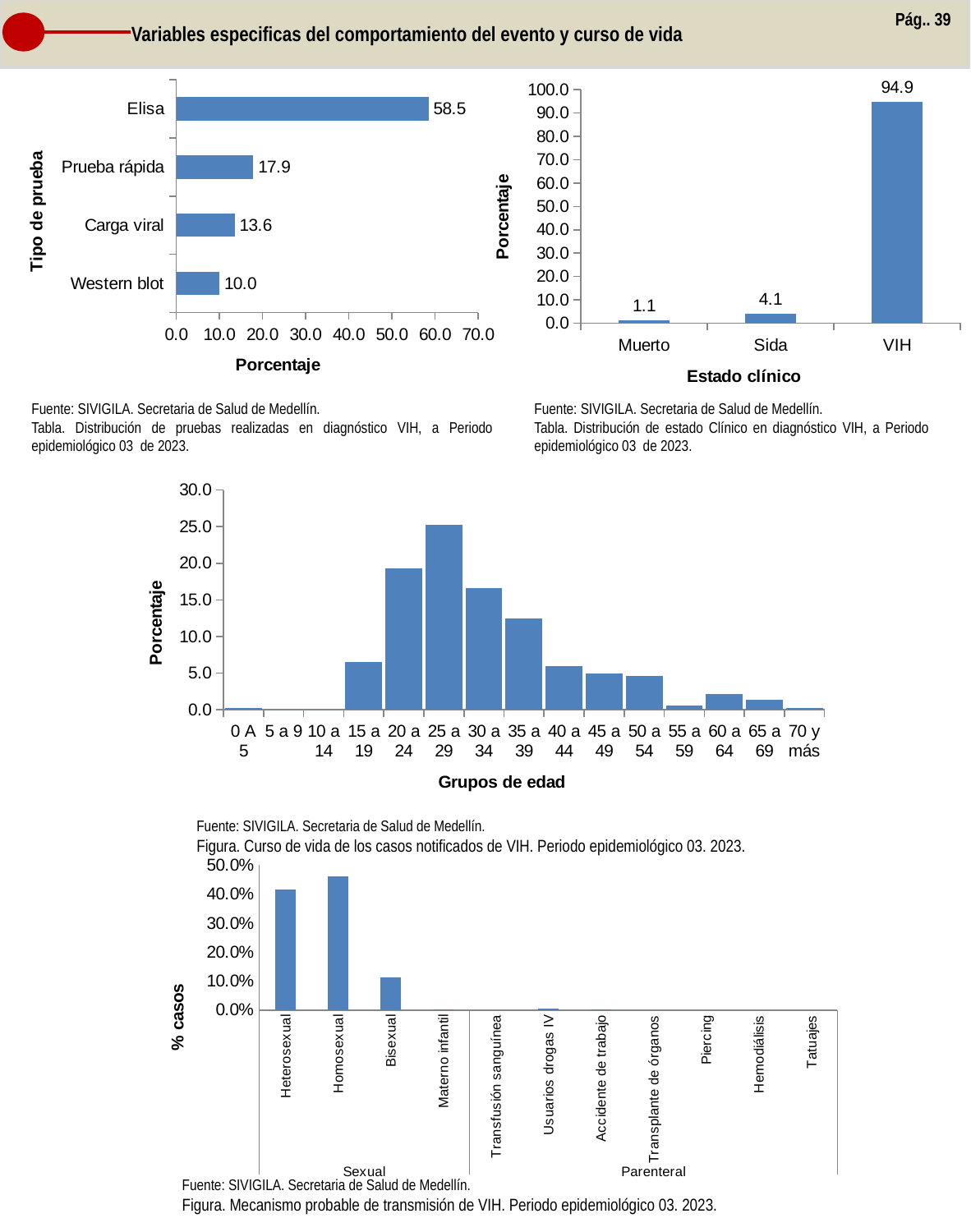
In the bottom chart (Mecanismo probable de transmisión), is the value for Homosexual greater or less than 50.0%? less In the top-left chart (Tipo de prueba), what is the value for Elisa? 58.5 In the top-left chart (Tipo de prueba), what is the difference between Prueba rápida and Carga viral? 4.3 In the top-right chart (Estado clínico), what is the difference between VIH and Muerto? 93.8 In the top-right chart (Estado clínico), which category has the highest percentage? VIH In the middle chart (Grupos de edad), is the value for 35 a 39 greater or less than 10.0? greater In the top-right chart (Estado clínico), what is the value for Sida? 4.1 In the middle chart (Grupos de edad), how many age groups are shown on the x axis? 15 In the top-left chart (Tipo de prueba), how many test types are shown? 4 In the middle chart (Grupos de edad), which age group has the highest percentage? 25 a 29 In the bottom chart (Mecanismo probable de transmisión), which of Heterosexual or Homosexual has the larger value? Homosexual In the top-left chart (Tipo de prueba), which test type has the lowest percentage? Western blot